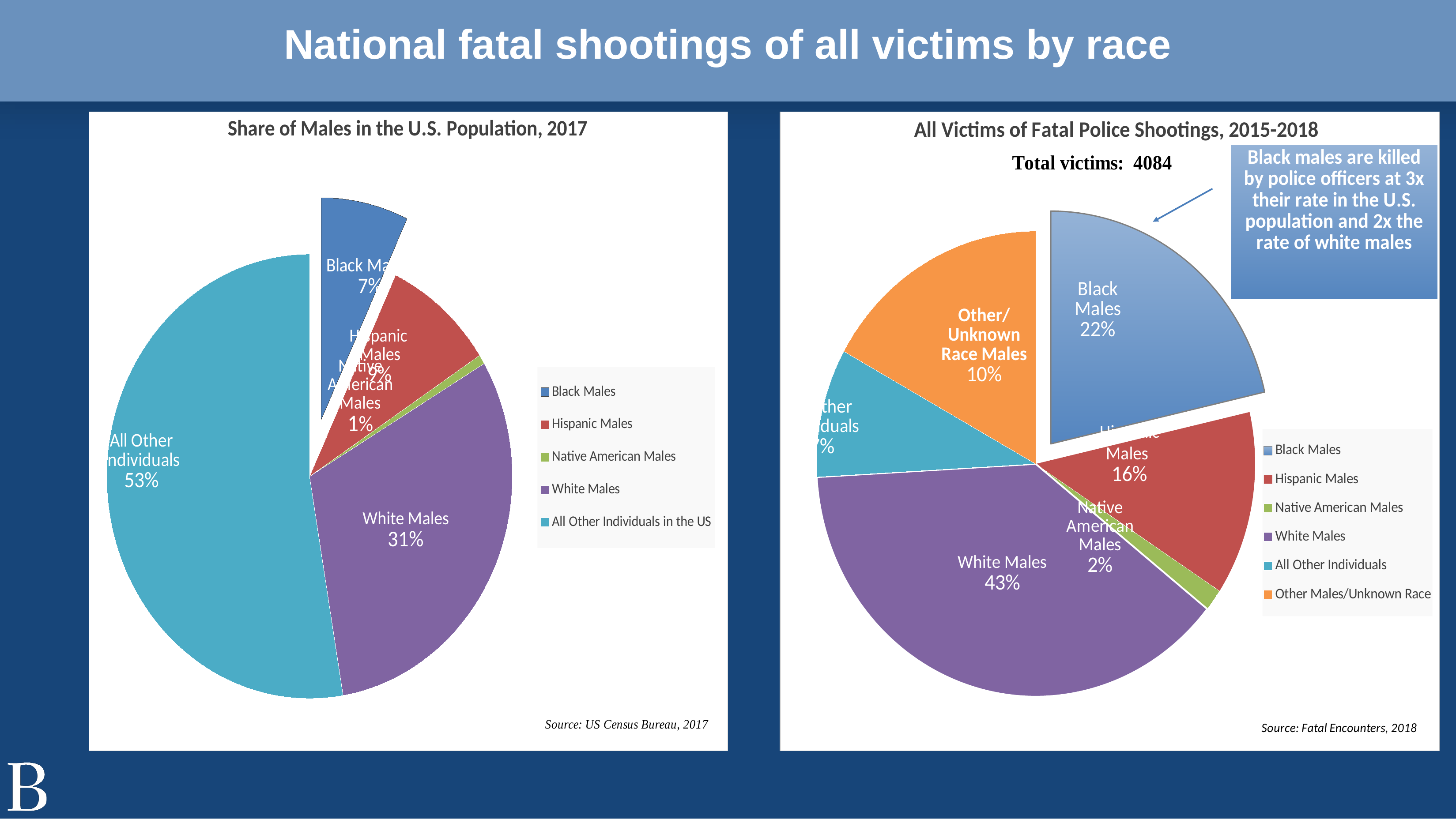
In the 'All Victims of Fatal Police Shootings, 2015-2018' chart, what share do White Males have? 43% What kind of chart is the 'Share of Males in the U.S. Population, 2017' chart? Pie chart In the 'All Victims of Fatal Police Shootings, 2015-2018' chart, what share do Other/Unknown Race Males have? 10% In the 'All Victims of Fatal Police Shootings, 2015-2018' chart, what is the difference between the White Males share and the Black Males share? 21% In the 'All Victims of Fatal Police Shootings, 2015-2018' chart, what share do Black Males have? 22% In the 'Share of Males in the U.S. Population, 2017' chart, what share do White Males have? 31% In the 'Share of Males in the U.S. Population, 2017' chart, what share do Black Males have? 7% How many entries does the legend of the 'All Victims of Fatal Police Shootings, 2015-2018' chart list? 6 In the 'All Victims of Fatal Police Shootings, 2015-2018' chart, which is larger: the share for Hispanic Males or the share for Native American Males? Hispanic Males In the 'Share of Males in the U.S. Population, 2017' chart, which category has the largest share? All Other Individuals What is the total number of victims stated on the 'All Victims of Fatal Police Shootings, 2015-2018' chart? 4084 In the 'Share of Males in the U.S. Population, 2017' chart, which category has the smallest share? Native American Males